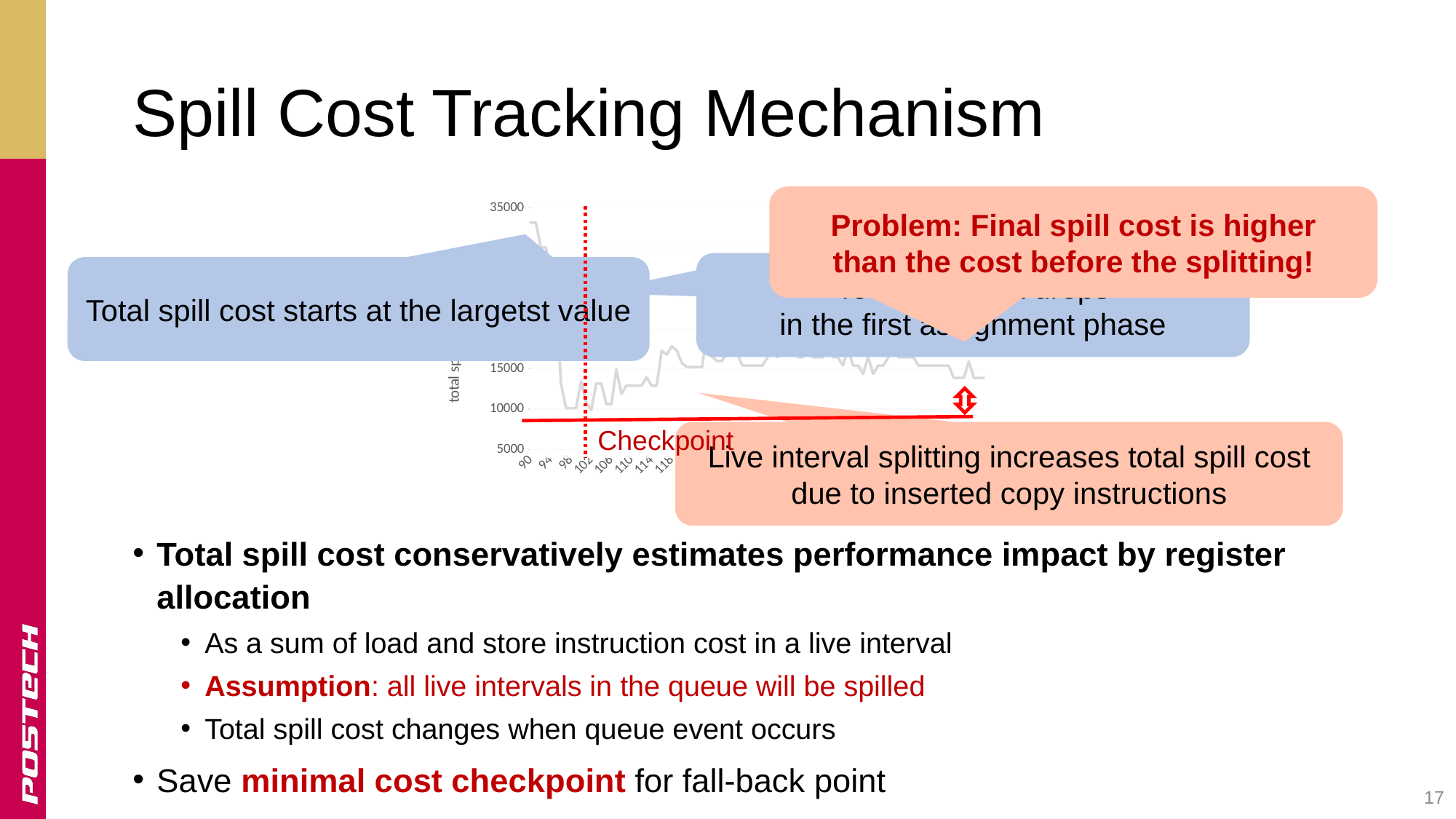
Is the value at the right end of the line greater or less than 35000? less Do the values in the chart generally rise or fall along the x axis? fall What is the highest tick value shown on the y axis of the chart? 35000 Is the value at the start of the line (around x = 90) greater or less than 15000? greater What kind of chart is shown on the slide? line chart What label is written next to the red dotted vertical line in the chart? Checkpoint